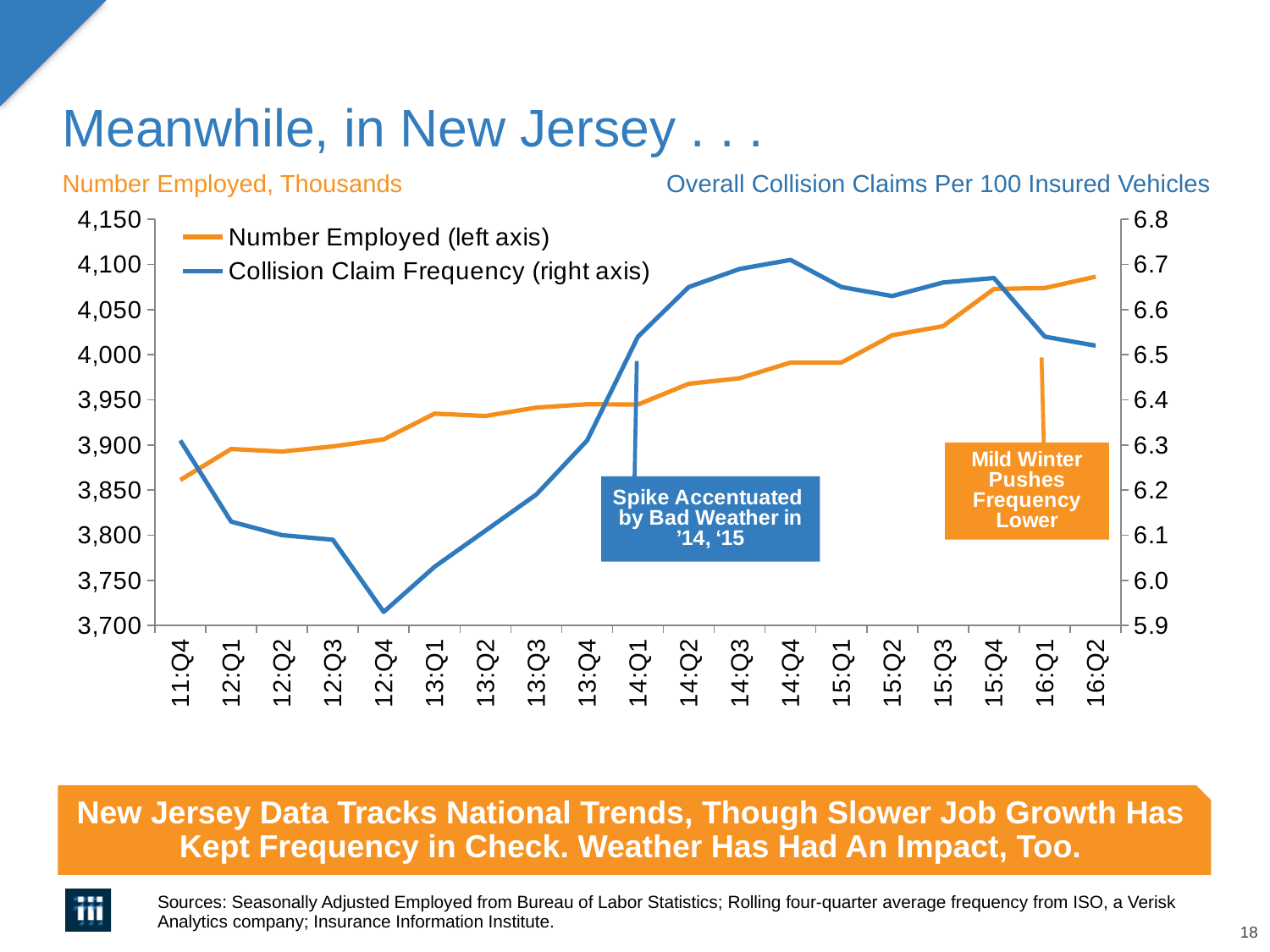
Is the Collision Claim Frequency value for 14:Q4 greater or less than 6.6? greater How many quarters are plotted along the x axis? 19 In which quarter does the Collision Claim Frequency line reach its highest point? 14:Q4 Is the Number Employed value for 11:Q4 greater or less than 3,900? less In which quarter is the Collision Claim Frequency line at its lowest? 12:Q4 Is the Collision Claim Frequency value for 12:Q4 greater or less than 6.0? less In which quarter is Number Employed at its lowest? 11:Q4 What kind of chart is shown on the slide? Line chart How many series does the chart legend list? 2 Does the Number Employed line rise or fall overall from 11:Q4 to 16:Q2? Rise Which series is plotted against the right axis? Collision Claim Frequency